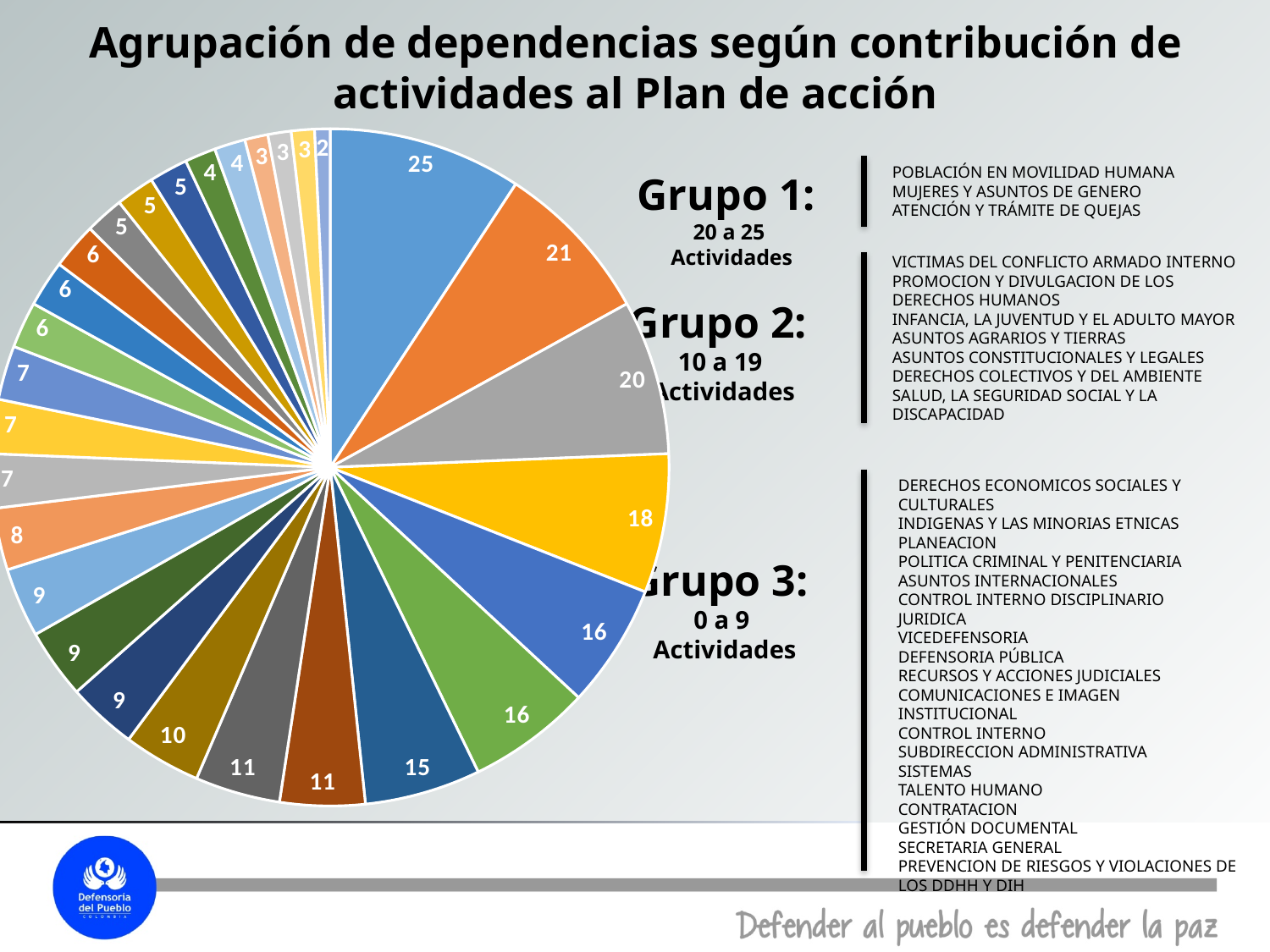
What is the difference between the largest slice (25) and the second largest slice (21)? 4 How many slices in the pie chart are labelled 9? 3 How many slices does the pie chart have? 29 How many slices in the pie chart have a value of 20 or more? 3 What kind of chart is shown on the slide? pie chart Which is larger, the slice labelled 18 or the slice labelled 15? 18 What is the value of the smallest slice in the pie chart? 2 What is the title of the slide's chart? Agrupación de dependencias según contribución de actividades al Plan de acción How many groups (Grupo) are listed to the right of the pie chart? 3 What is the total of all the slice values in the pie chart? 271 What is the value of the largest slice in the pie chart? 25